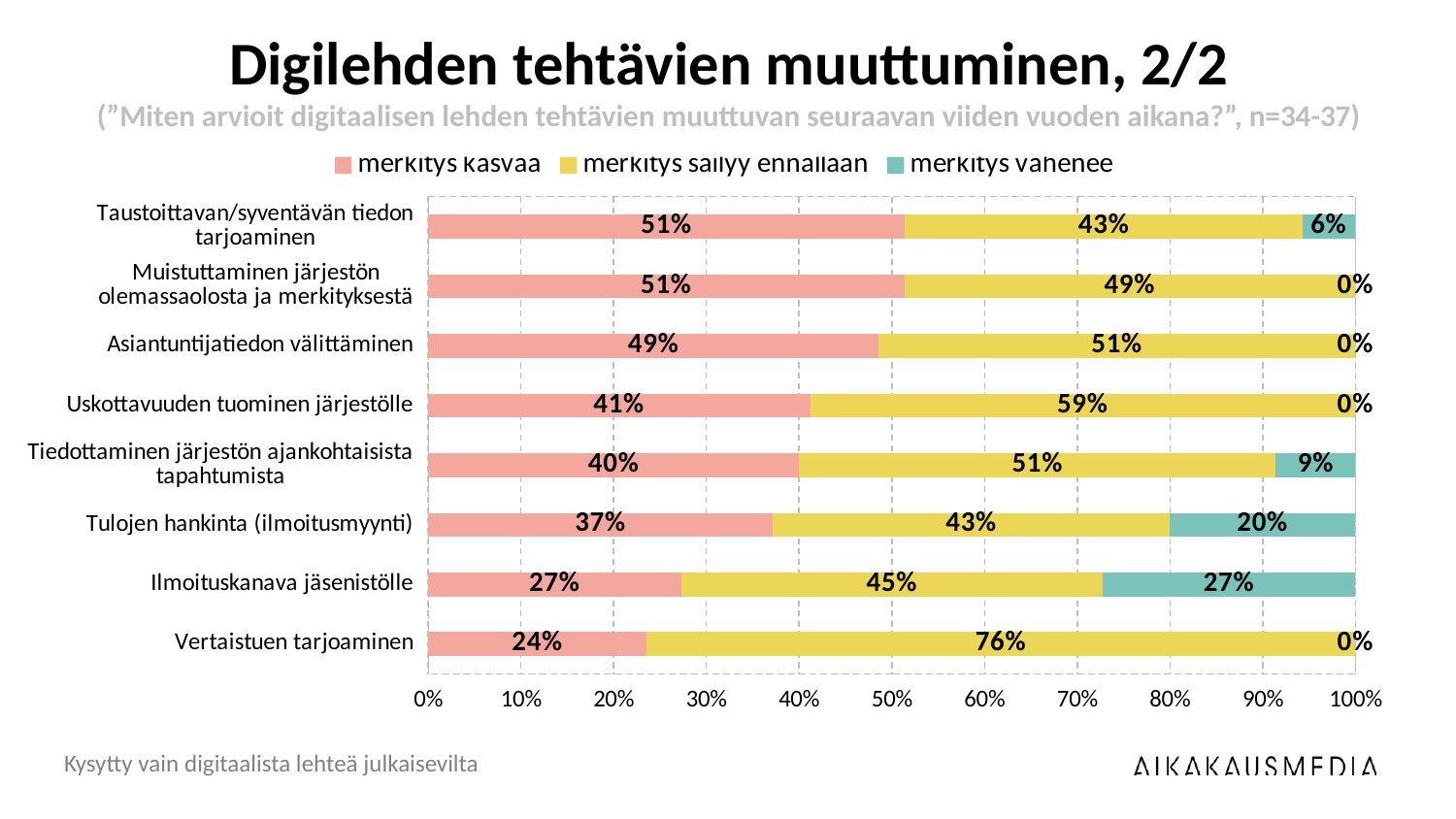
What is the 'merkitys vähenee' value for 'Tulojen hankinta (ilmoitusmyynti)'? 20% What is the 'merkitys vähenee' value for 'Tiedottaminen järjestön ajankohtaisista tapahtumista'? 9% What kind of chart is shown on the slide? Stacked bar chart What is the difference between the 'merkitys kasvaa' values for 'Taustoittavan/syventävän tiedon tarjoaminen' and 'Ilmoituskanava jäsenistölle'? 24% How many series does the legend list? 3 Which category has the highest 'merkitys vähenee' value? Ilmoituskanava jäsenistölle Which category has the lowest 'merkitys kasvaa' value? Vertaistuen tarjoaminen What is the 'merkitys kasvaa' value for 'Vertaistuen tarjoaminen'? 24% Which is larger: the 'merkitys kasvaa' value for 'Asiantuntijatiedon välittäminen' or for 'Tiedottaminen järjestön ajankohtaisista tapahtumista'? Asiantuntijatiedon välittäminen How many categories are shown in the chart? 8 Which category has the highest 'merkitys säilyy ennallaan' value? Vertaistuen tarjoaminen What is the 'merkitys säilyy ennallaan' value for 'Uskottavuuden tuominen järjestölle'? 59%